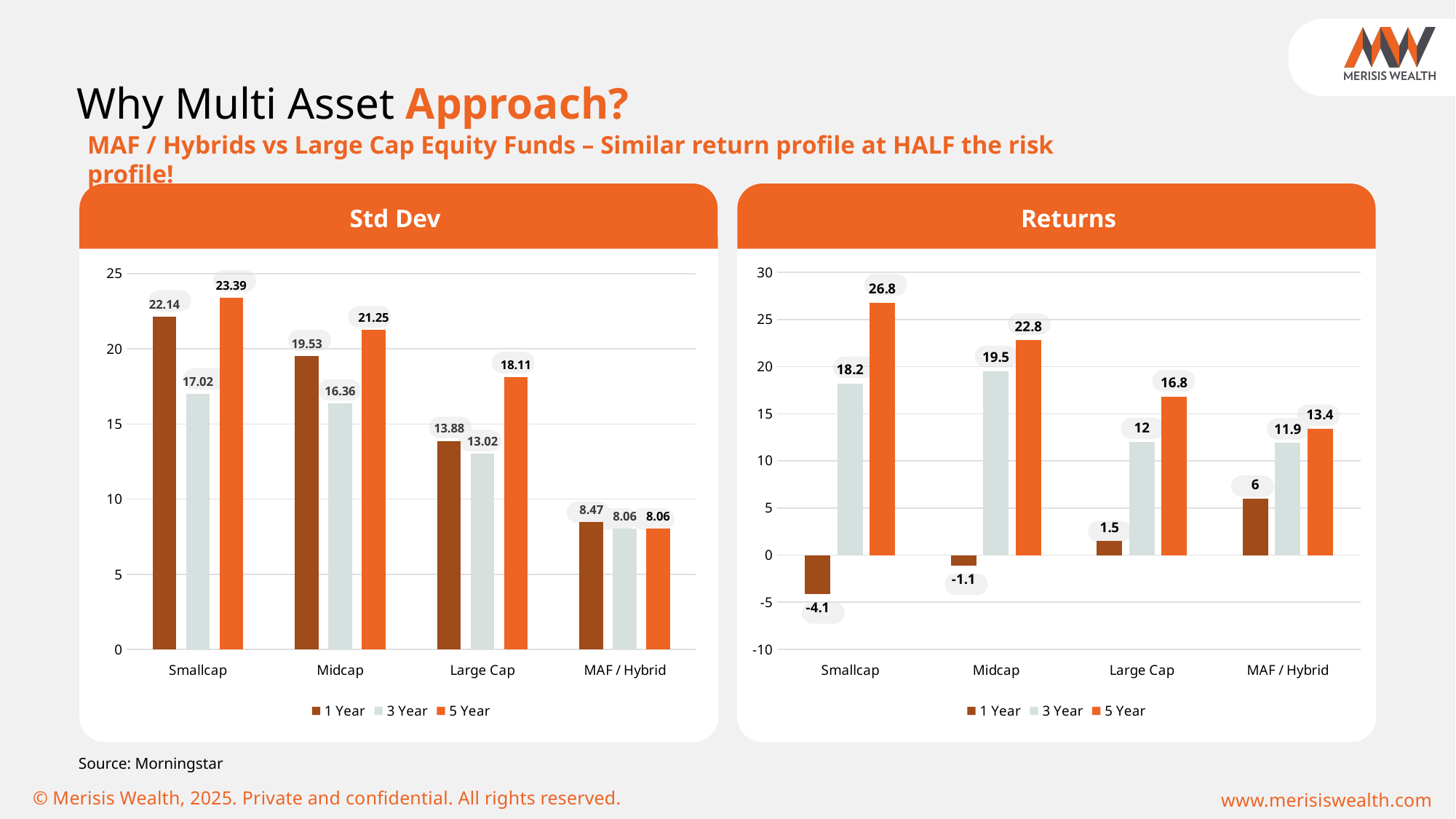
In the Returns chart, what is the difference between the 5 Year values for Large Cap and MAF / Hybrid? 3.4 What kind of chart is the Returns chart? Bar chart How many series does the legend of the Returns chart list? 3 In the Returns chart, is the 3 Year value for Midcap greater or less than 15? greater In the Std Dev chart, which category has the lowest 1 Year value? MAF / Hybrid In the Returns chart, what is the 1 Year value for Smallcap? -4.1 In the Std Dev chart, which is larger: the 1 Year value for Midcap or the 3 Year value for Midcap? 1 Year (19.53) In the Std Dev chart, what is the 3 Year value for Large Cap? 13.02 In the Std Dev chart, what is the 5 Year value for Smallcap? 23.39 In the Std Dev chart, do the 5 Year values rise or fall from Smallcap to MAF / Hybrid? Fall In the Returns chart, which category has the highest 5 Year value? Smallcap How many categories are shown on the x axis of the Std Dev chart? 4